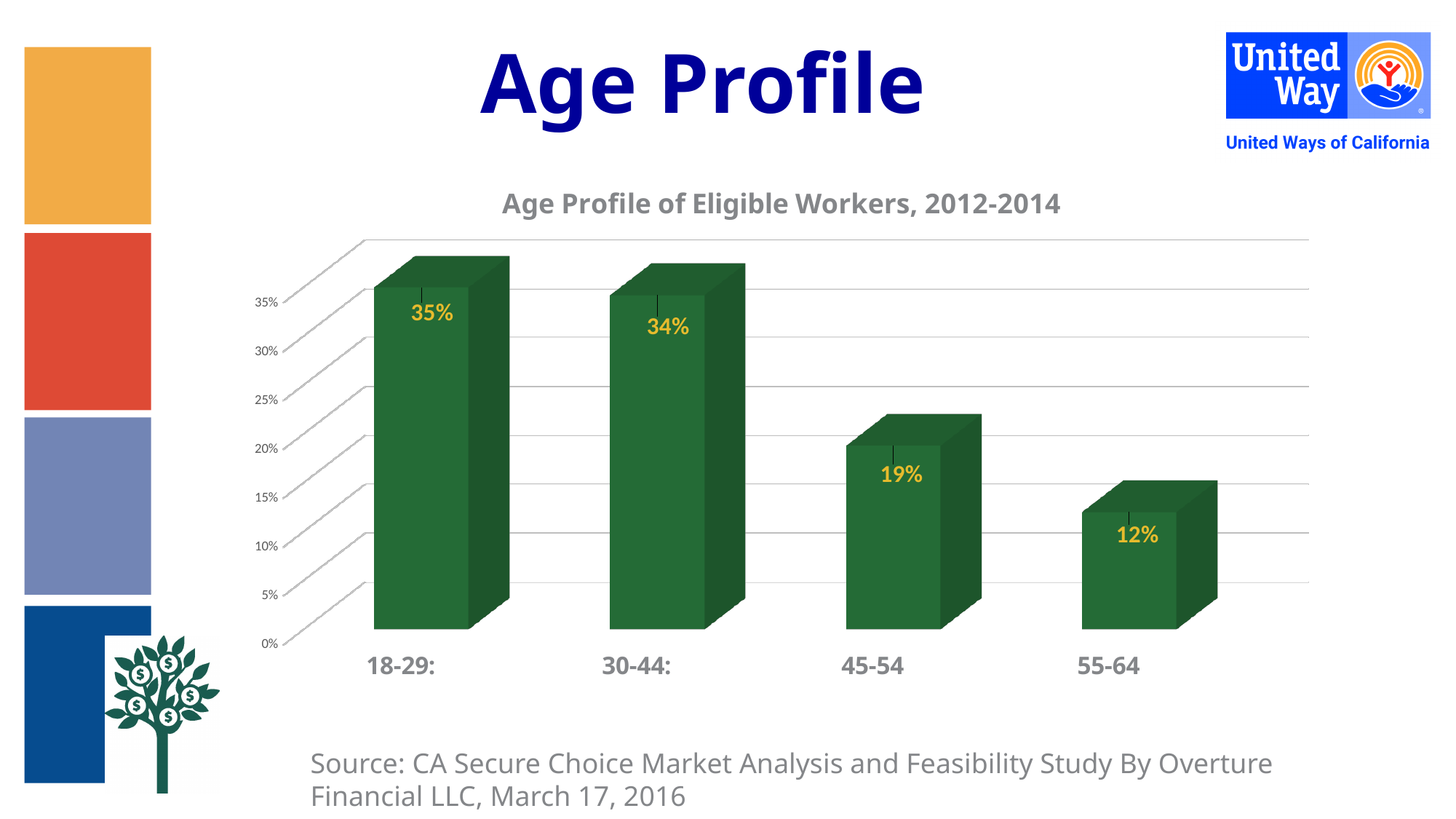
What is the title of the chart? Age Profile of Eligible Workers, 2012-2014 What is the difference between the values for the 45-54 and 55-64 age groups? 7% What kind of chart is shown on the slide? Bar chart Which age group has the lowest value? 55-64 What is the value for the 55-64 age group? 12% How many age groups are shown in the chart? 4 Do the values rise or fall from left to right across the age groups? Fall Which is larger, the value for 30-44 or the value for 45-54? 30-44 What is the value for the 18-29 age group? 35% What is the value for the 30-44 age group? 34% Which age group has the highest value? 18-29 What is the value for the 45-54 age group? 19%